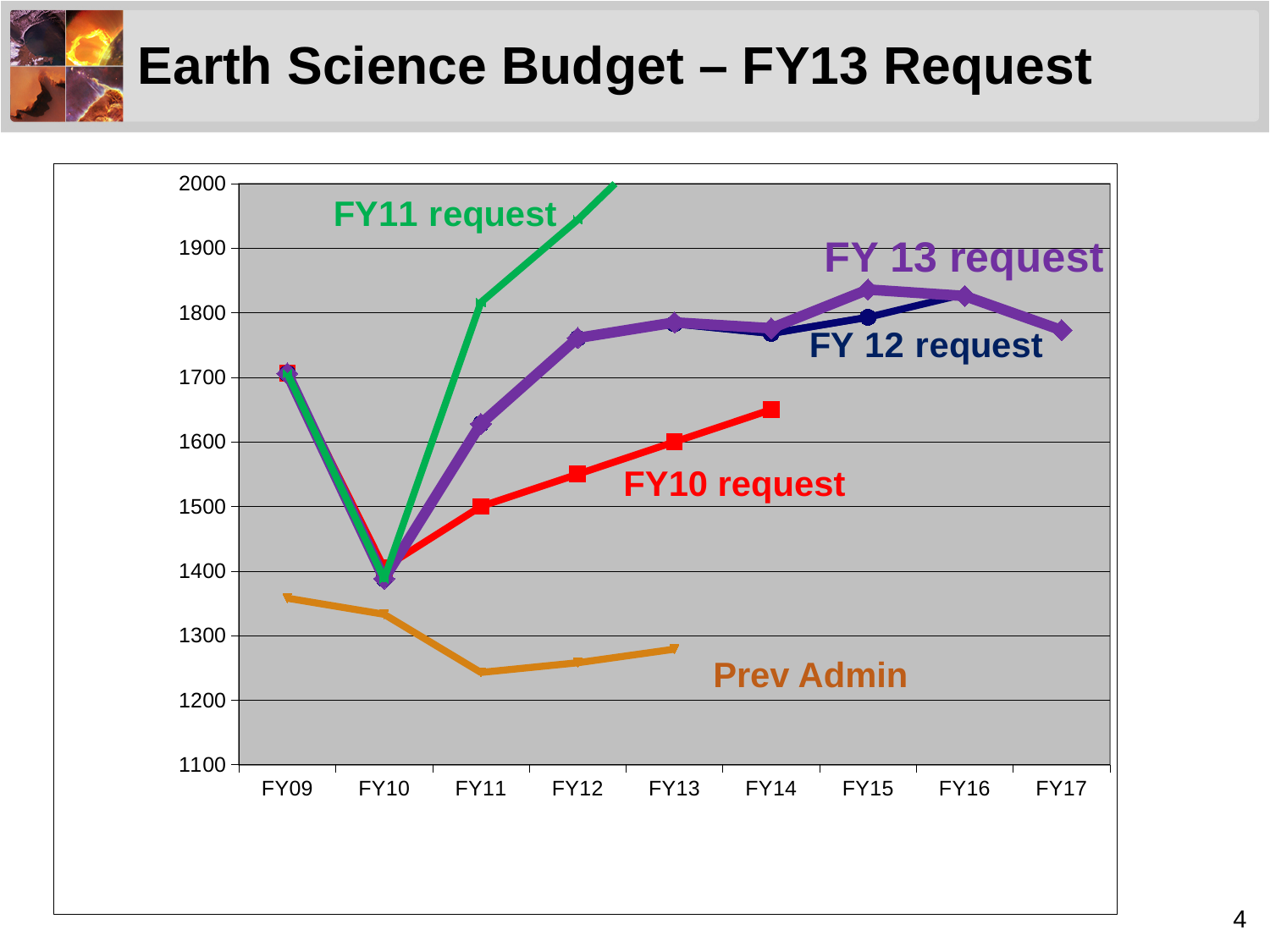
Is the FY10 request value for FY14 greater or less than 1600? greater At FY13, which is larger: the FY 13 request value or the FY10 request value? FY 13 request Which series is the only one that extends to FY17? FY 13 request Is the FY 13 request value for FY15 greater or less than 1800? greater In which fiscal year does the FY 13 request line reach its lowest point? FY10 What kind of chart is shown on the slide? line chart Does the FY10 request line rise or fall from FY10 to FY14? rise Is the FY11 request value for FY11 greater or less than 1700? greater How many labelled series (lines) does the chart show? 5 Does the Prev Admin line rise or fall from FY09 to FY11? fall How many fiscal years are shown on the x axis of the chart? 9